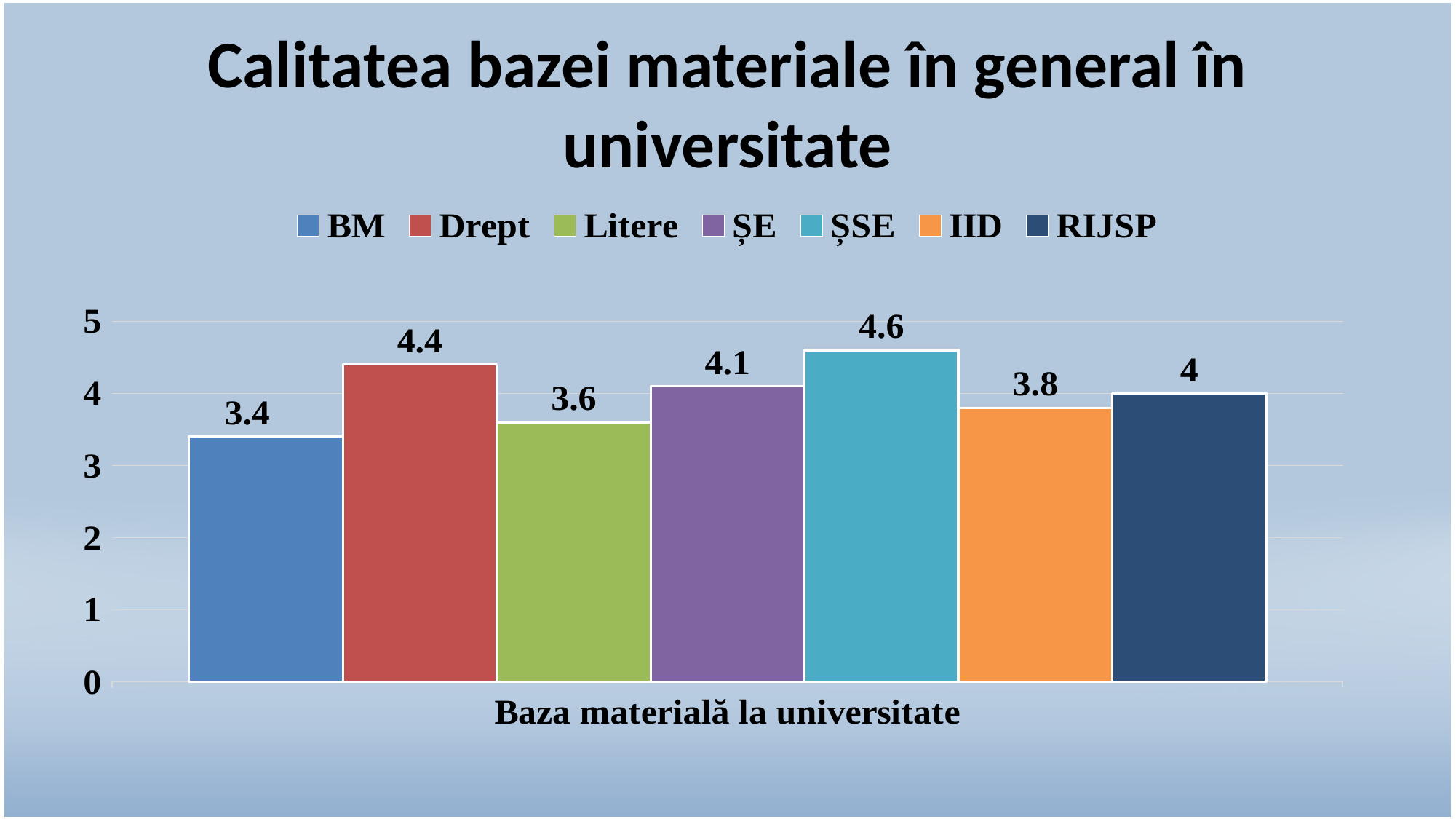
What kind of chart is shown on the slide? bar chart What is the value for ȘSE? 4.6 Which series has the lowest value? BM What is the value for BM? 3.4 What is the value for IID? 3.8 Is the value for Drept greater or less than 4? greater How many series does the legend list? 7 What is the difference between the values for Drept and Litere? 0.8 Which is larger, the value for ȘE or the value for RIJSP? ȘE What is the title of the chart? Calitatea bazei materiale în general în universitate What is the label on the x axis? Baza materială la universitate Which series has the highest value? ȘSE